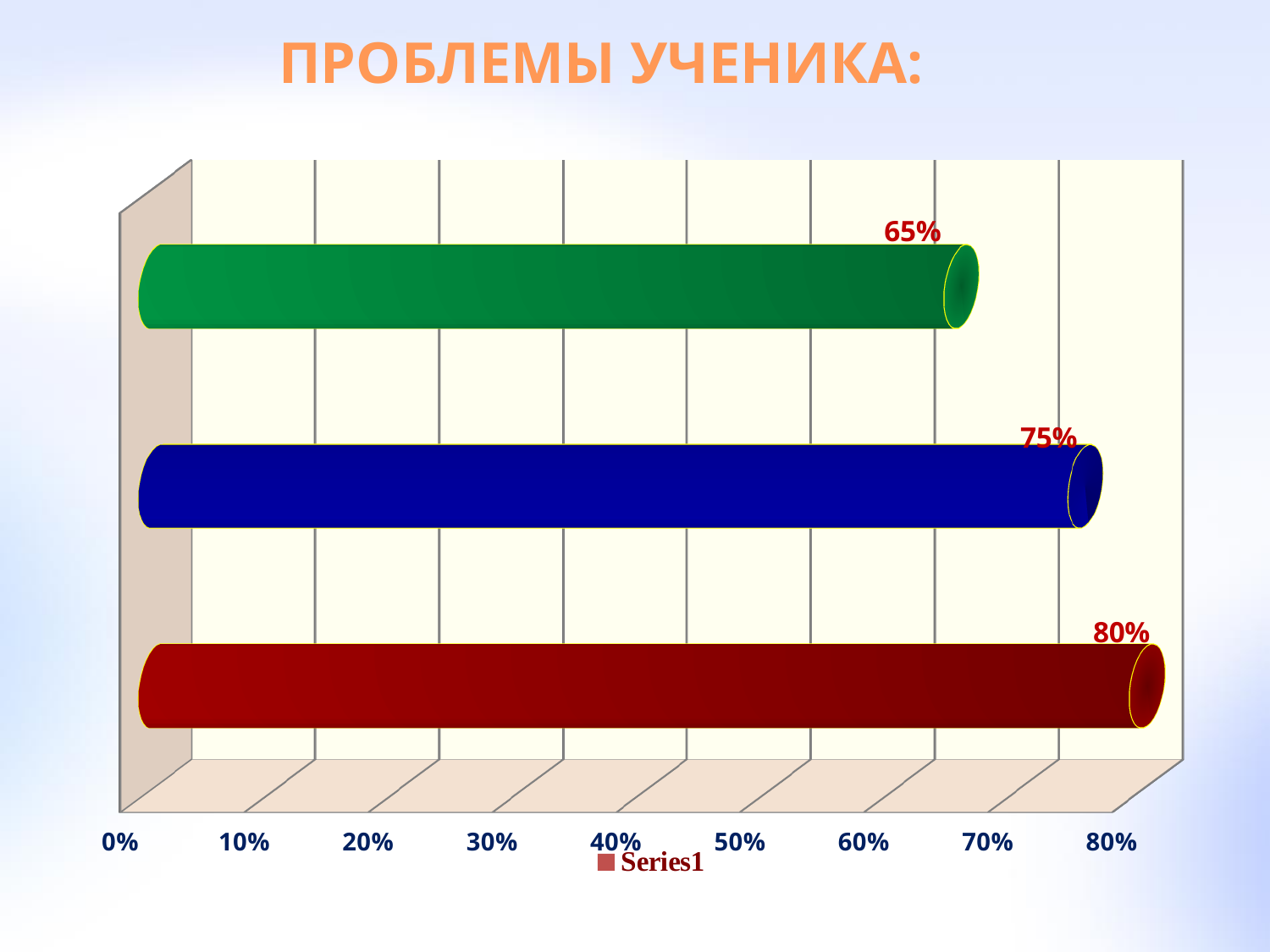
How many bars are plotted in the chart? 3 Which bar has the lowest value? The green (top) bar, 65% What value is shown on the red (bottom) bar? 80% Is the value of the green bar greater or less than 70%? less What value is shown on the green (top) bar? 65% What is the difference between the blue bar's value and the green bar's value? 10% What kind of chart is shown on the slide? Bar chart What value is shown on the blue (middle) bar? 75% What series name does the legend show? Series1 Which bar has the highest value? The red (bottom) bar, 80% Which is larger, the value of the blue bar or the value of the green bar? The blue bar What is the difference between the red bar's value and the green bar's value? 15%